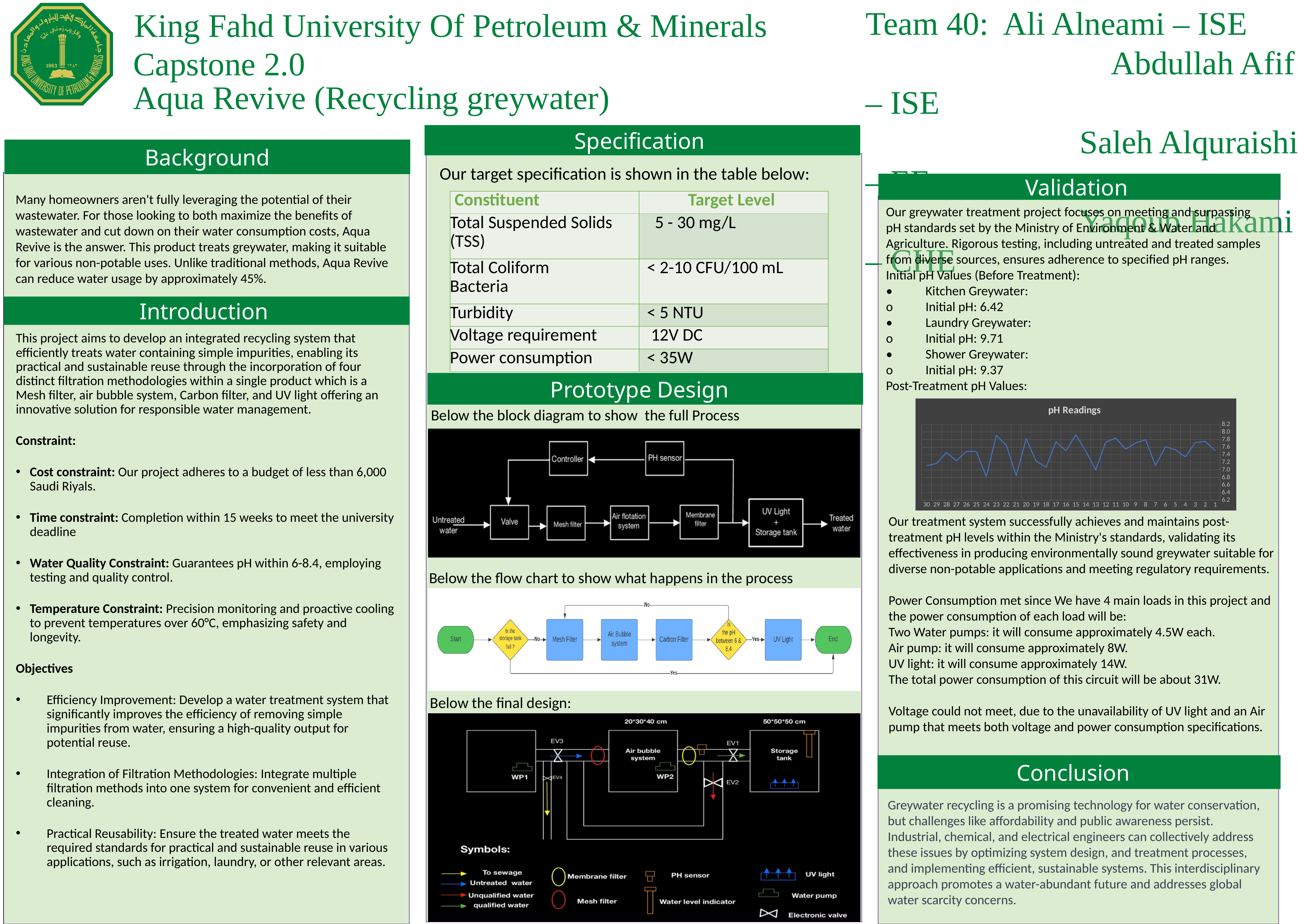
How many readings are plotted along the x axis of the 'pH Readings' chart? 30 In the 'pH Readings' chart, which is larger, the value at reading 15 or the value at reading 13? reading 15 What is the title of the chart in the Validation section? pH Readings In the 'pH Readings' chart, which is larger, the value at reading 23 or the value at reading 21? reading 23 In the 'pH Readings' chart, is the value at reading 15 greater or less than 7.6? greater What kind of chart is the 'pH Readings' chart? line chart In the 'pH Readings' chart, is the value at reading 23 greater or less than 7.6? greater In the 'pH Readings' chart, are all plotted values above 6.2? yes What is the highest value shown on the y axis of the 'pH Readings' chart? 8.2